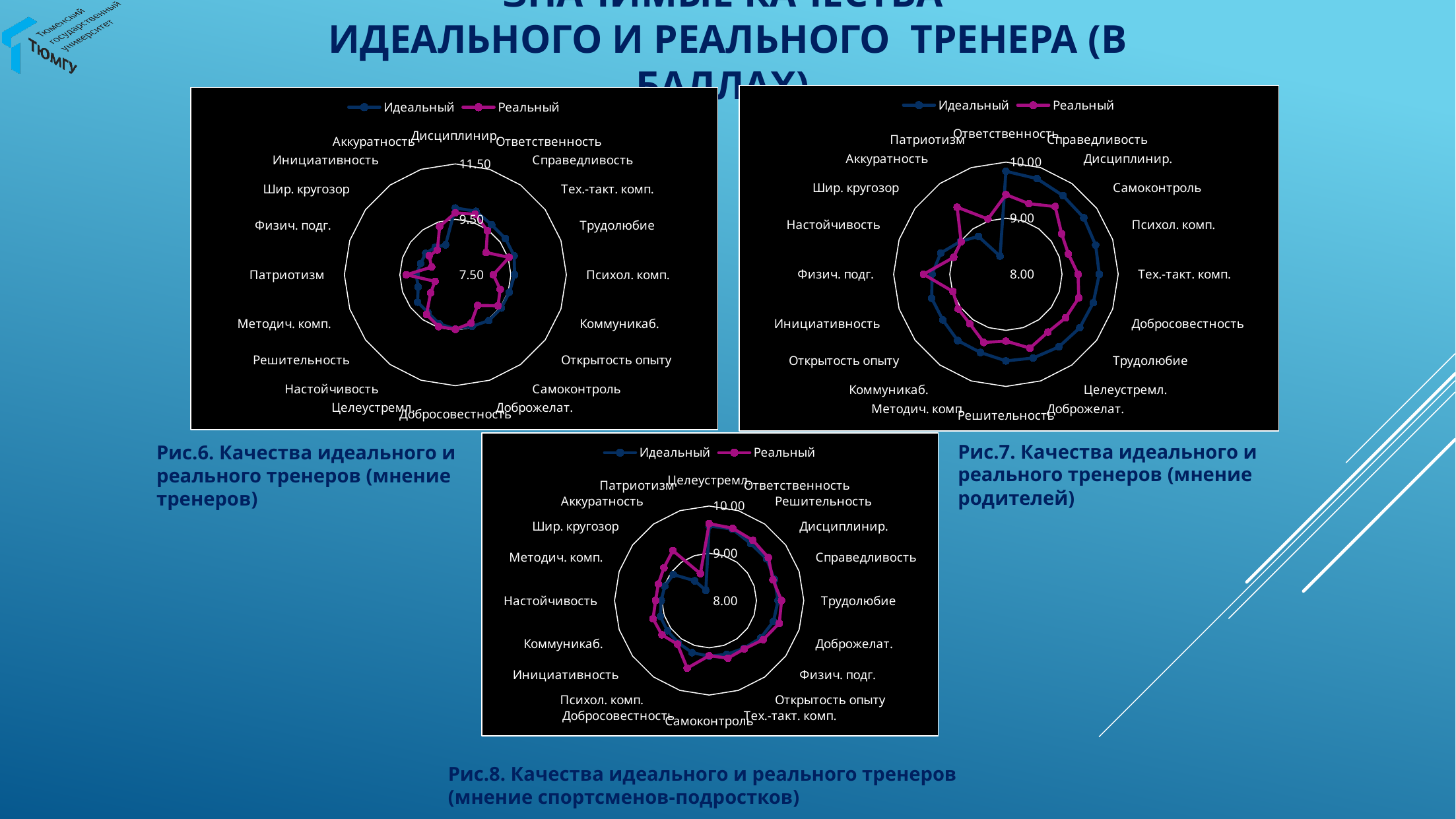
In Рис.7 (top-right chart), is the Реальный value for Физич. подг. greater or less than 9.00? greater In Рис.7 (top-right chart), which series has the larger value for Патриотизм, Идеальный or Реальный? Реальный How many series does the legend of Рис.7 (top-right chart) list? 2 In Рис.8 (bottom chart), is the Идеальный value for Патриотизм greater or less than 9.00? less In Рис.7 (top-right chart), what is the value of the outermost axis ring? 10.00 In Рис.8 (bottom chart), what are the two series named in the legend? Идеальный and Реальный What kind of chart is Рис.6 (top-left chart)? Radar chart How many qualities (categories) are plotted around Рис.6 (top-left chart)? 20 In Рис.6 (top-left chart), is the Идеальный value for Патриотизм greater or less than 9.50? less How many categories are plotted around Рис.8 (bottom chart)? 20